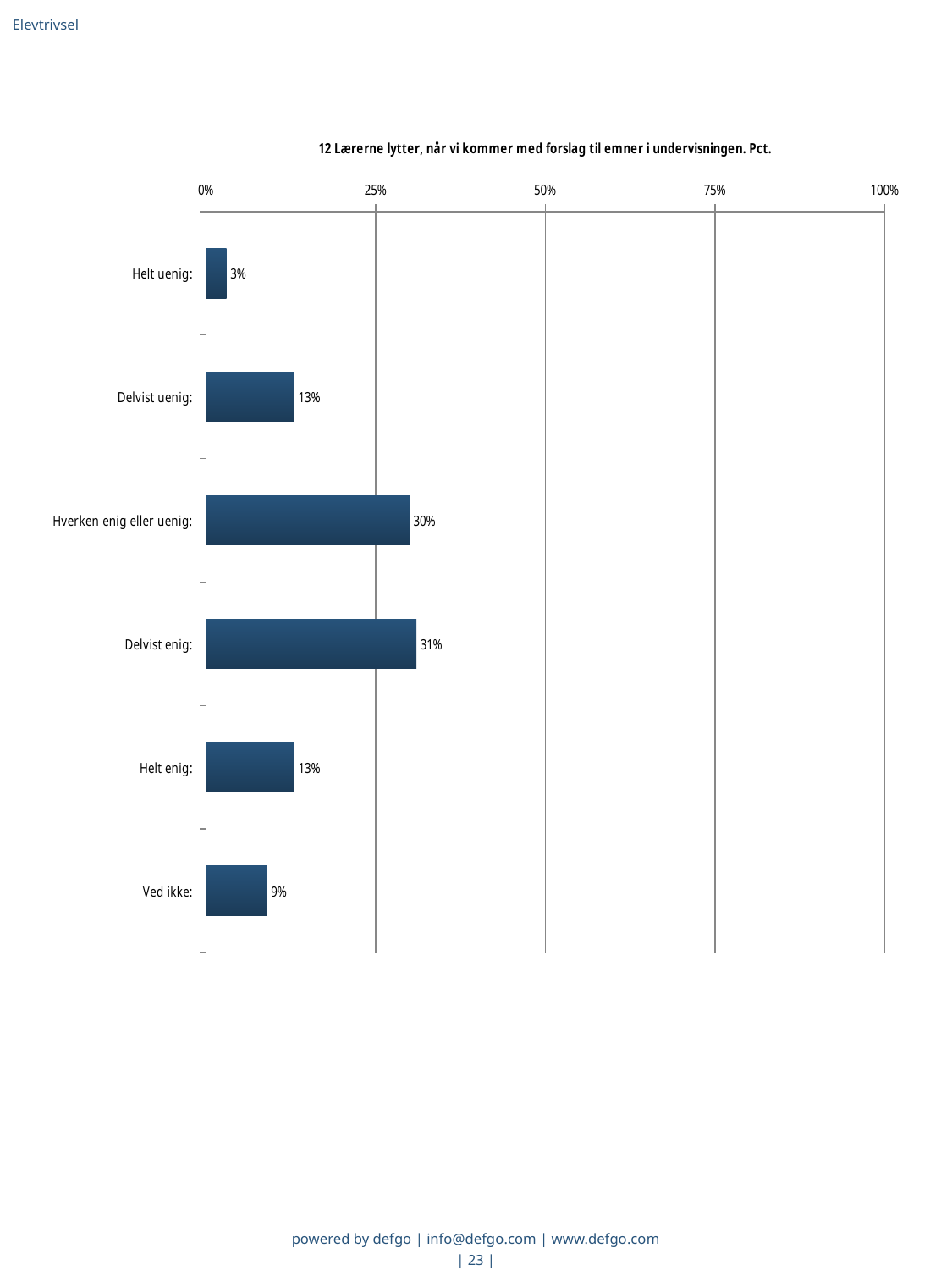
Is the value for "Delvist enig" greater or less than 25%? greater What is the title of the chart? 12 Lærerne lytter, når vi kommer med forslag til emner i undervisningen. Pct. What is the value for "Hverken enig eller uenig"? 30% What is the value for "Ved ikke"? 9% What kind of chart is shown on the slide? Bar chart What is the difference between the values for "Delvist enig" and "Helt enig"? 18% What is the value for "Helt uenig"? 3% Which category has the lowest value? Helt uenig How many categories are shown in the chart? 6 Which category has the highest value? Delvist enig What is the value for "Delvist uenig"? 13% Which is larger, the value for "Ved ikke" or the value for "Helt uenig"? Ved ikke